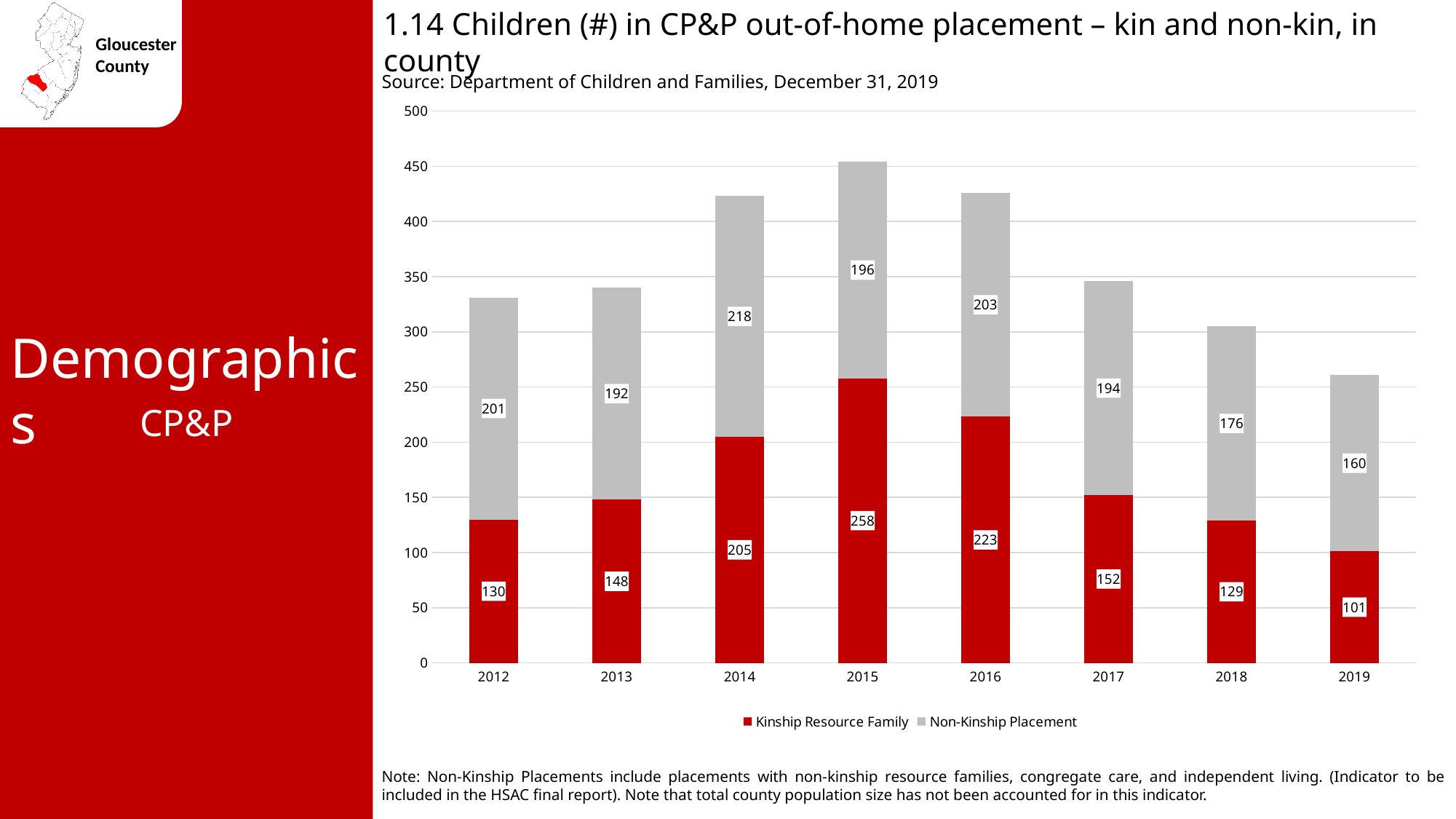
What is the difference between the Non-Kinship Placement values for 2016 and 2019? 43 What kind of chart is shown on the slide? Stacked bar chart What is the Non-Kinship Placement value for 2014? 218 What is the Kinship Resource Family value for 2015? 258 Which is larger, the Kinship Resource Family value for 2013 or for 2018? 2013 How many years are shown on the x axis? 8 What is the total of the stacked bar for 2019? 261 Which year has the highest Kinship Resource Family value? 2015 Which colour represents Kinship Resource Family in the chart? Red Is the total height of the 2015 stacked bar greater or less than 400? greater How many series does the legend list? 2 Which year has the lowest Non-Kinship Placement value? 2019